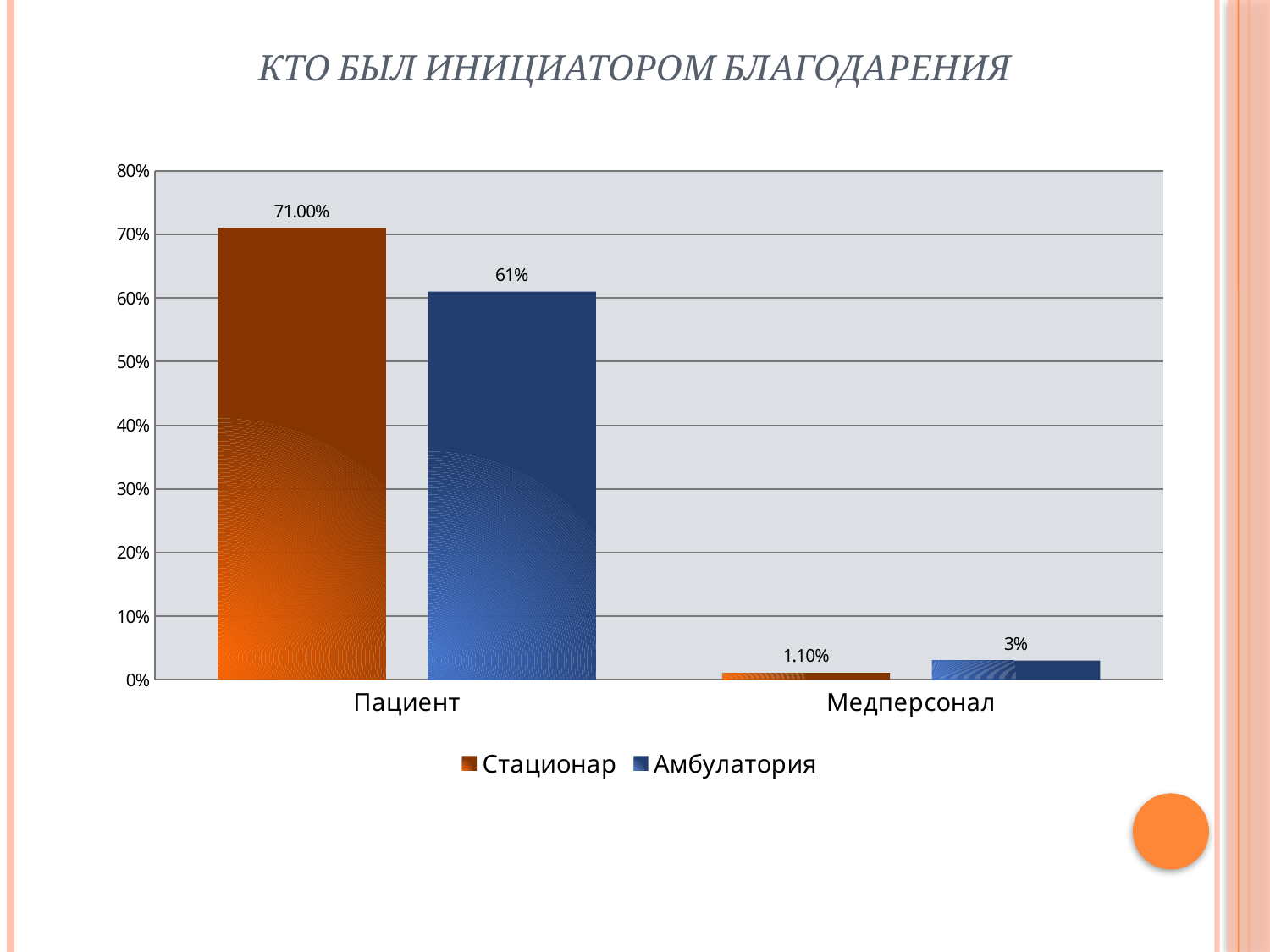
What is the value for Амбулатория in the Пациент category? 61% Which category has the highest value for the Стационар series? Пациент In the Медперсонал category, which series has the larger value, Стационар or Амбулатория? Амбулатория How many series does the legend list? 2 What is the value for Стационар in the Медперсонал category? 1.10% What is the difference between the Стационар and Амбулатория values in the Пациент category? 10% Is the value for Амбулатория in the Пациент category greater or less than 50%? greater What kind of chart is shown on the slide? bar chart What is the value for Амбулатория in the Медперсонал category? 3% What is the value for Стационар in the Пациент category? 71.00% Which category has the lowest value for the Амбулатория series? Медперсонал How many categories are shown on the x axis? 2